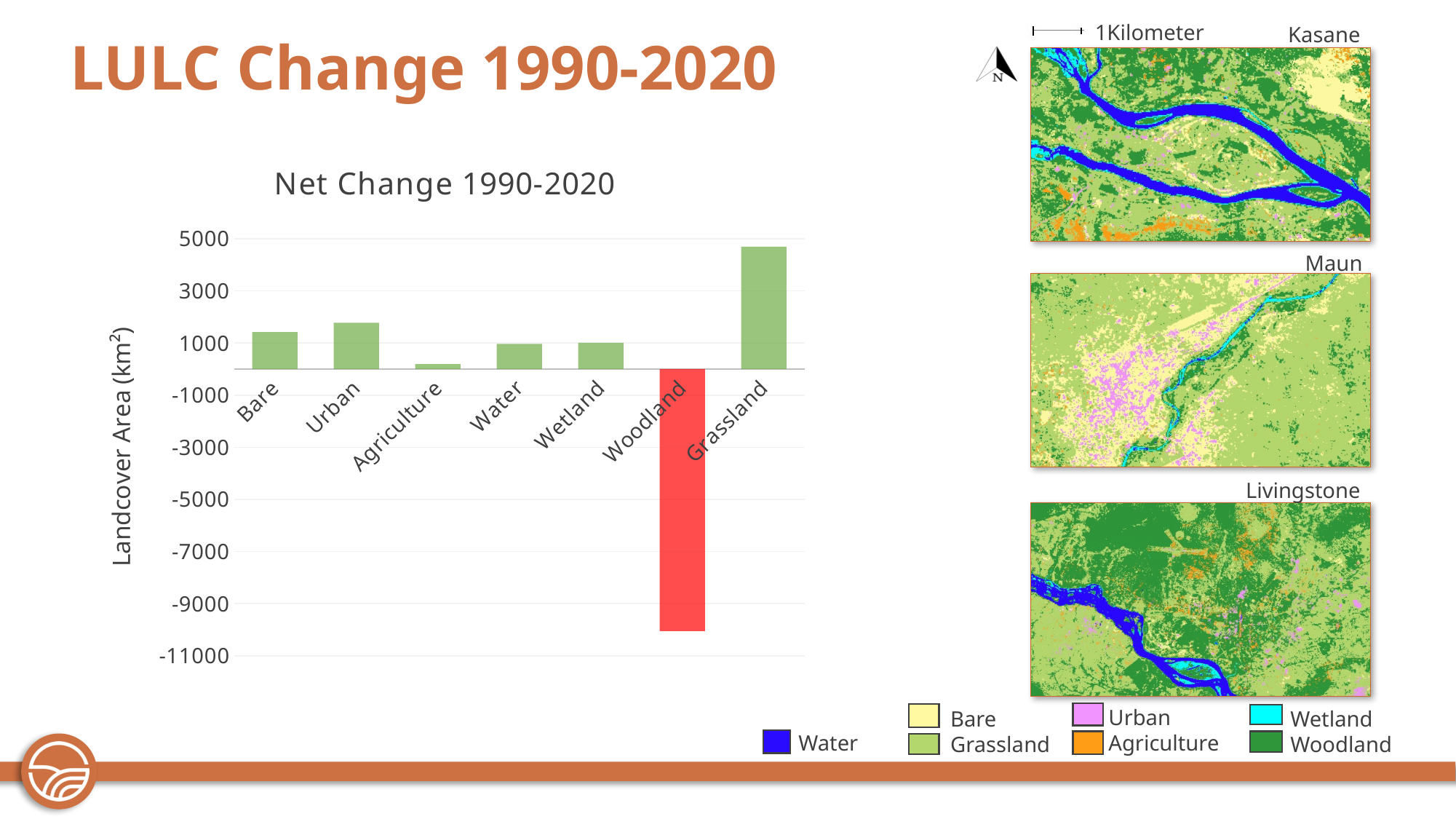
Which category has the lowest net change in the Net Change 1990-2020 chart? Woodland What is the title of the chart on the slide? Net Change 1990-2020 Is the net change for Urban greater or less than 1000? greater What kind of chart is shown on the slide? bar chart Which has a larger net change, Grassland or Urban? Grassland Which category has the highest net change in the Net Change 1990-2020 chart? Grassland How many land cover categories are plotted in the Net Change 1990-2020 chart? 7 What is the label of the vertical axis in the Net Change 1990-2020 chart? Landcover Area (km²) Is the net change for Woodland greater or less than -9000? less Is the net change for Grassland greater or less than 3000? greater Which has a larger net change, Urban or Bare? Urban